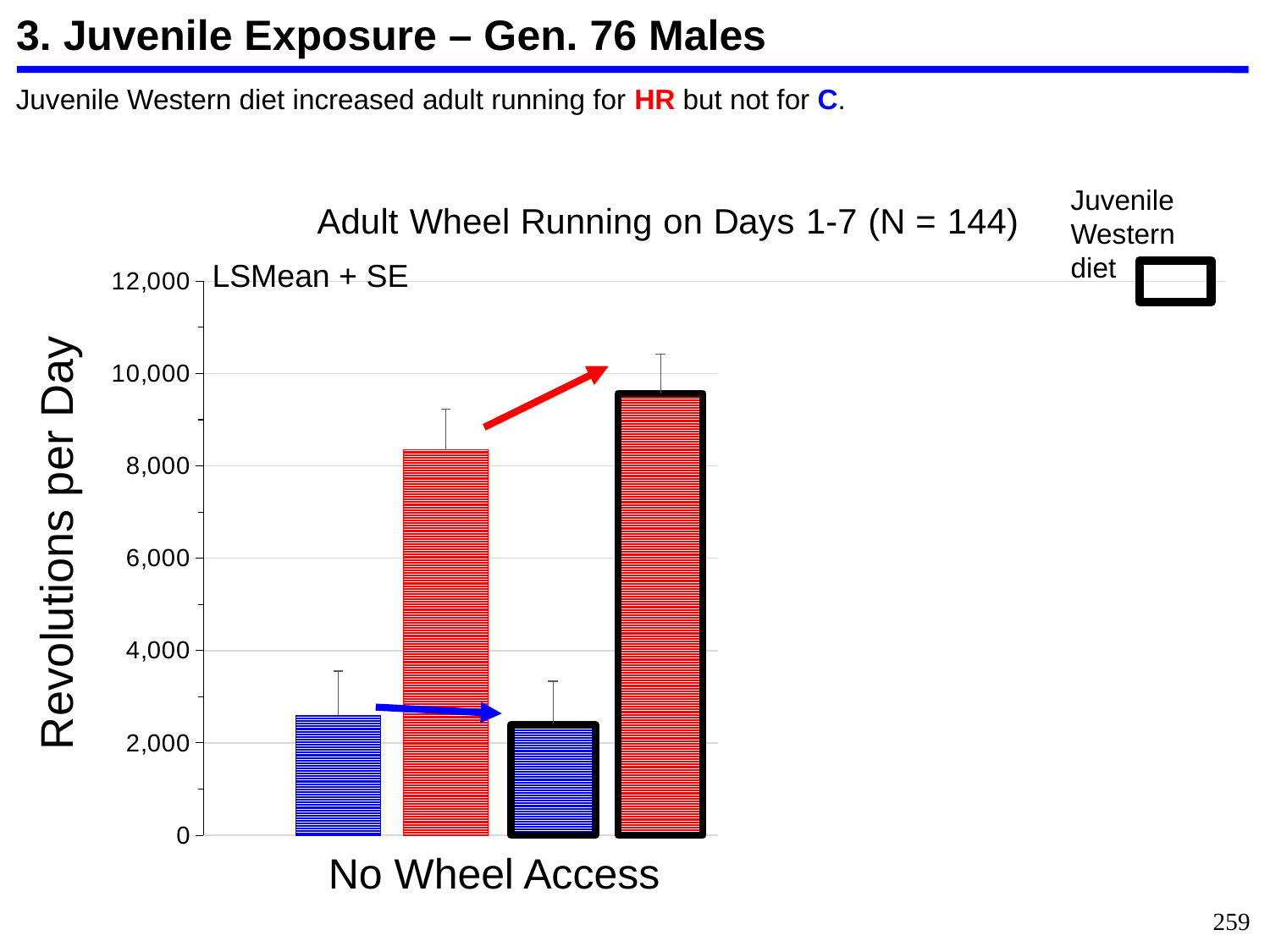
Which is larger: the red bar with the black outline or the red bar without the outline? the red bar with the black outline How many bars are plotted in the chart? 4 Which is larger: the red bar without the outline or the blue bar without the outline? the red bar without the outline What is the title of the chart? Adult Wheel Running on Days 1-7 (N = 144) What is the highest value shown on the vertical axis? 12,000 Is the value of the blue bar with the black outline greater or less than 4,000? less Is the value of the first blue bar (without the black outline) greater or less than 4,000? less What kind of chart is shown on the slide? bar chart Is the value of the red bar without the black outline greater or less than 6,000? greater Which bar is the tallest in the chart? the red bar with the black outline (HR, juvenile Western diet) What is the label on the vertical axis of the chart? Revolutions per Day